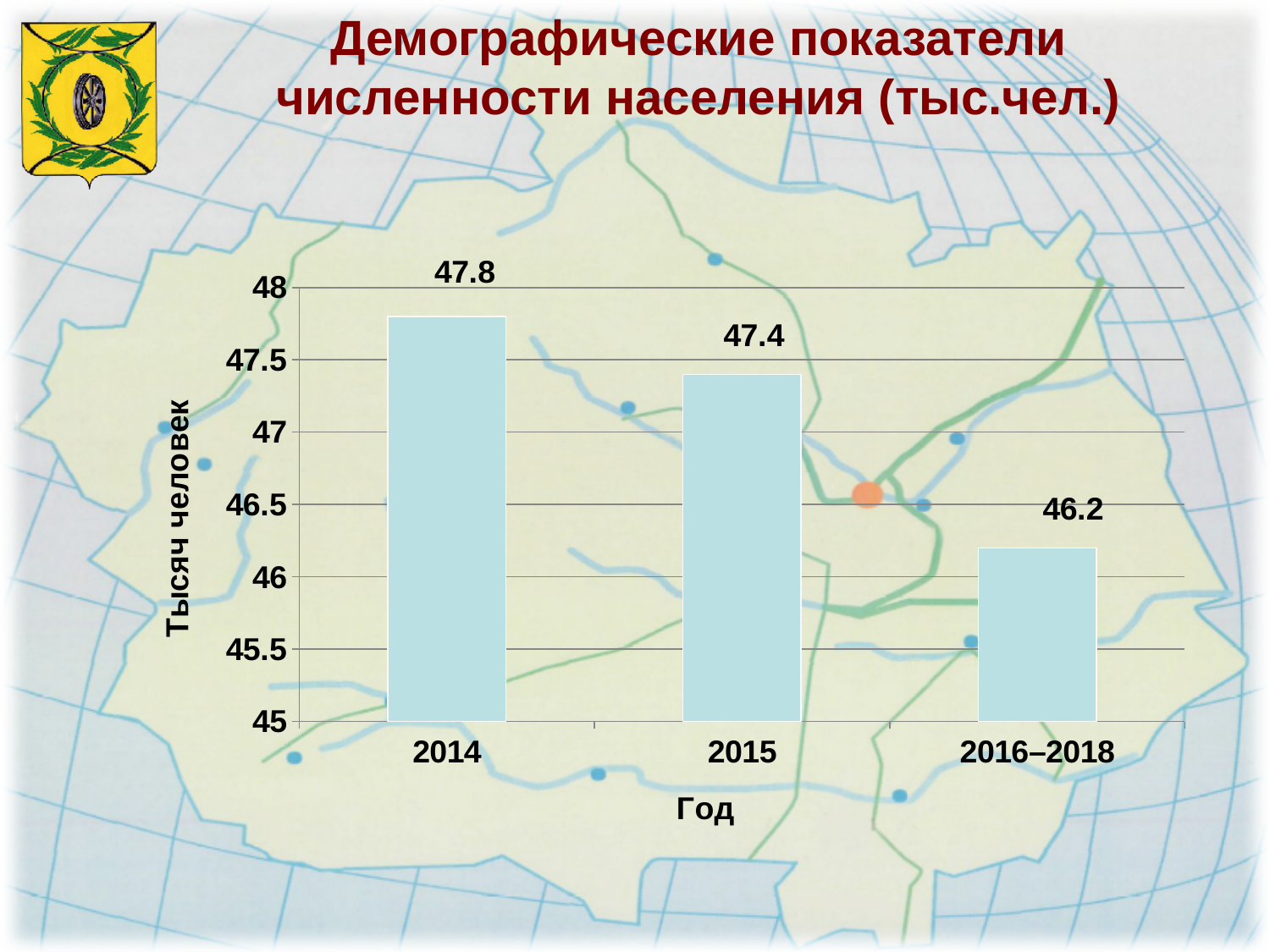
How many categories are shown on the x axis? 3 Is the value for 2016–2018 greater or less than 46.5? less What is the population value shown for 2015? 47.4 Do the values rise or fall from 2014 to 2016–2018? fall Which year category has the highest value? 2014 What is the difference between the values for 2014 and 2016–2018? 1.6 What kind of chart is shown on the slide? bar chart What is the difference between the values for 2014 and 2015? 0.4 What is the population value shown for 2014? 47.8 Which is larger, the value for 2015 or the value for 2016–2018? 2015 Which year category has the lowest value? 2016–2018 What is the population value shown for 2016–2018? 46.2